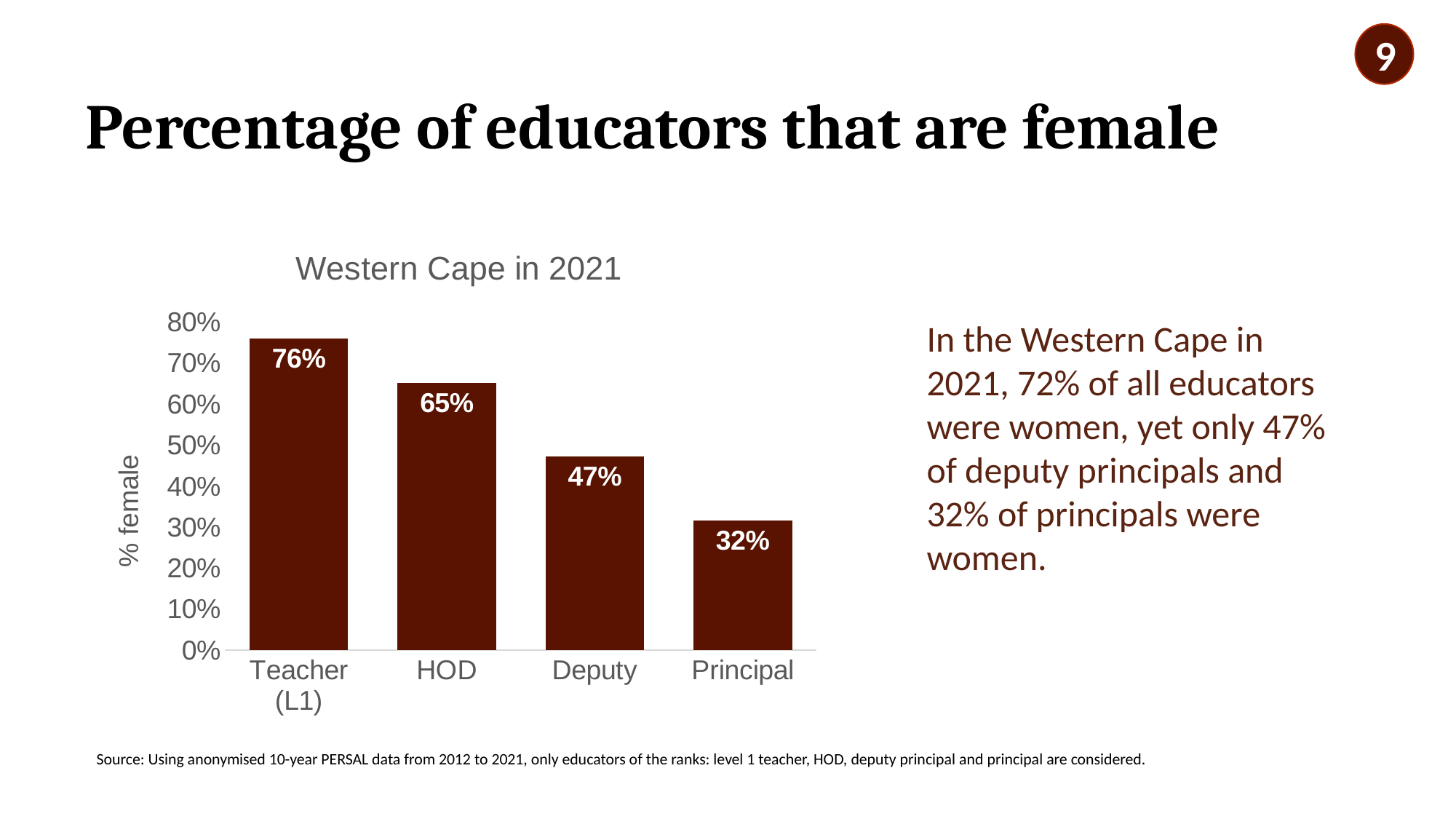
What is the difference between the Teacher (L1) and Principal values? 44% How many categories are shown on the x axis? 4 What is the difference between the HOD and Deputy values? 18% Do the values rise or fall from Teacher (L1) to Principal along the x axis? Fall Which is larger, the value for HOD or the value for Deputy? HOD What percentage of Teacher (L1) educators are female? 76% What is the value shown for HOD? 65% What percentage of Deputy educators are female? 47% What is the value shown for Principal? 32% Which category has the lowest percentage of female educators? Principal What kind of chart is shown on the slide? Bar chart Which category has the highest percentage of female educators? Teacher (L1)